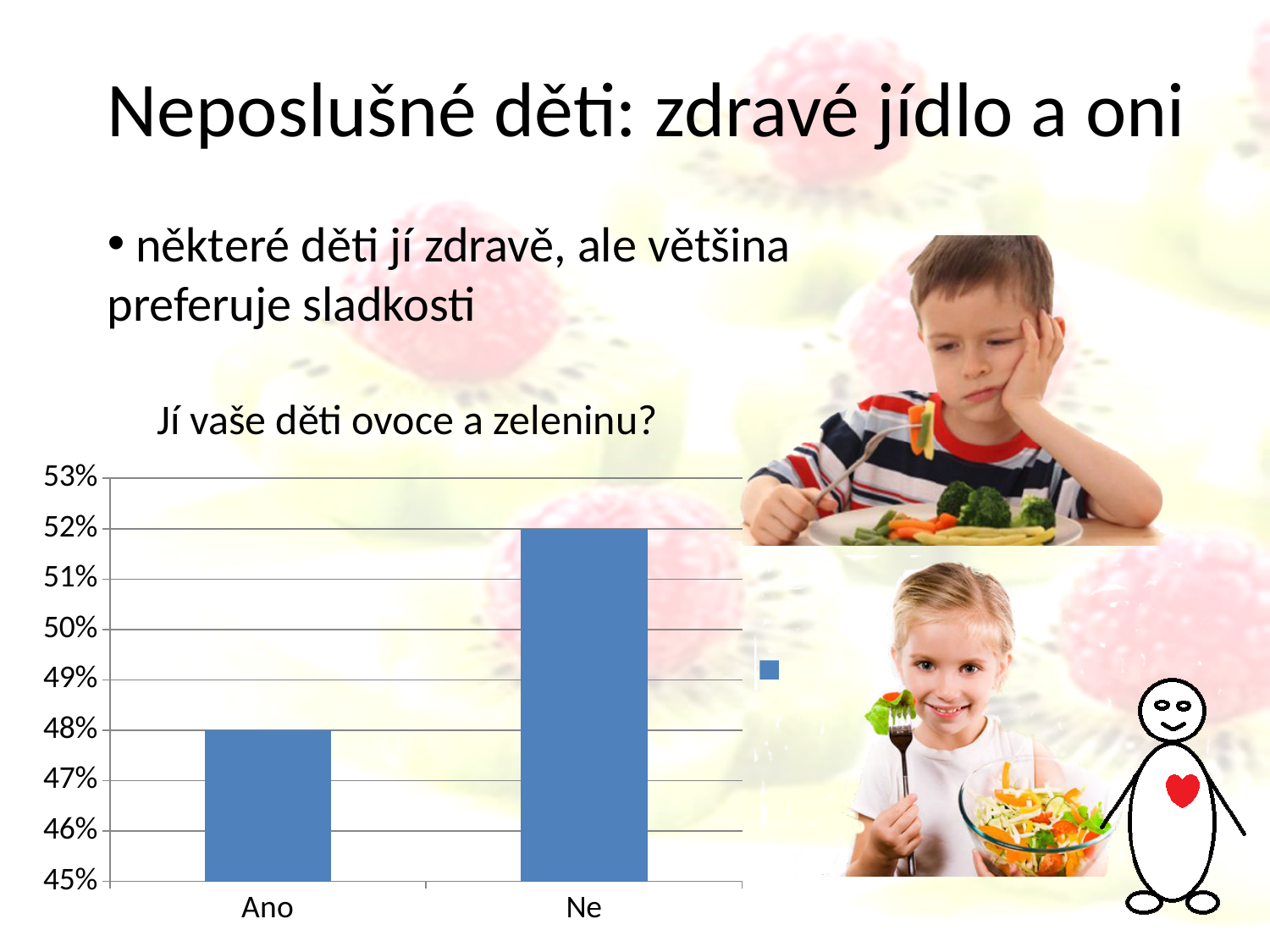
What is the value for "Ano" in the chart? 48% What is the title of the chart? Jí vaše děti ovoce a zeleninu? Which is larger, the value for "Ano" or the value for "Ne"? Ne How many categories are shown on the x axis of the chart? 2 What is the difference between the values for "Ne" and "Ano"? 4% What kind of chart is shown on the slide? bar chart Which category has the lowest value in the chart? Ano Which category has the highest value in the chart? Ne Is the value for "Ano" greater or less than 50%? less What is the value for "Ne" in the chart? 52% What colour are the bars in the chart? blue Is the value for "Ne" greater or less than 50%? greater